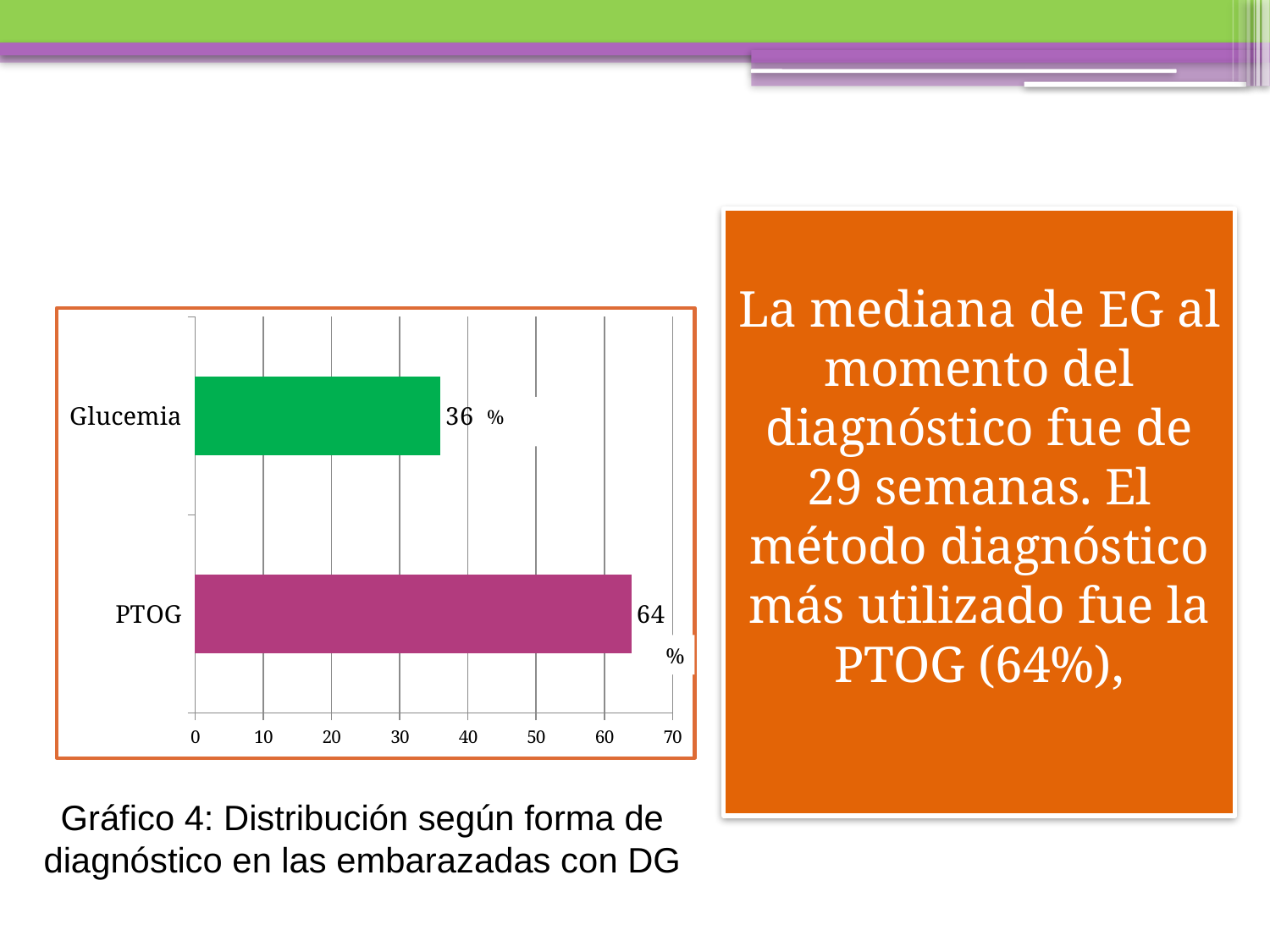
Is the value for Glucemia greater or less than 40? less What is the value for Glucemia? 36 What is the difference between the values for PTOG and Glucemia? 28 What is the value for PTOG? 64 What kind of chart is shown on the slide? Bar chart Which is larger, the value for PTOG or the value for Glucemia? PTOG What is the total of the two values shown in the chart? 100 How many categories are shown in the chart? 2 Which category has the lowest value? Glucemia Is the value for PTOG greater or less than 50? greater What is the caption of the chart on the slide? Gráfico 4: Distribución según forma de diagnóstico en las embarazadas con DG Which category has the highest value? PTOG